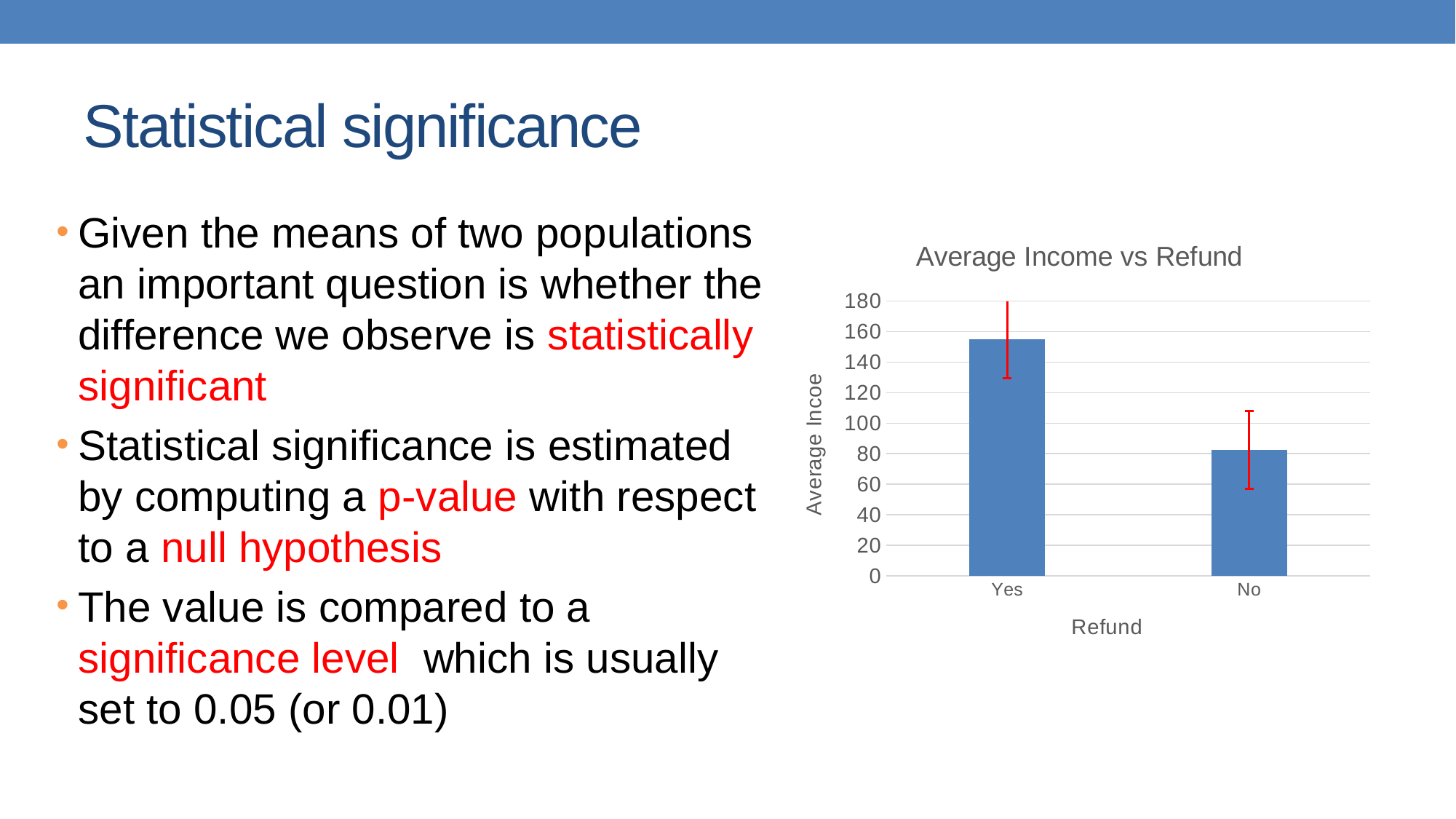
Is the average income for Yes greater or less than 160? less What is the title of the chart? Average Income vs Refund What kind of chart is shown on the slide? bar chart What is the label of the x axis? Refund Which category has the lowest average income? No Which is larger, the average income for Yes or for No? Yes Is the average income for No greater or less than 60? greater Do the bar values rise or fall from Yes to No along the x axis? fall Which category has the highest average income? Yes How many categories are shown on the x axis of the chart? 2 Is the average income for No greater or less than 100? less